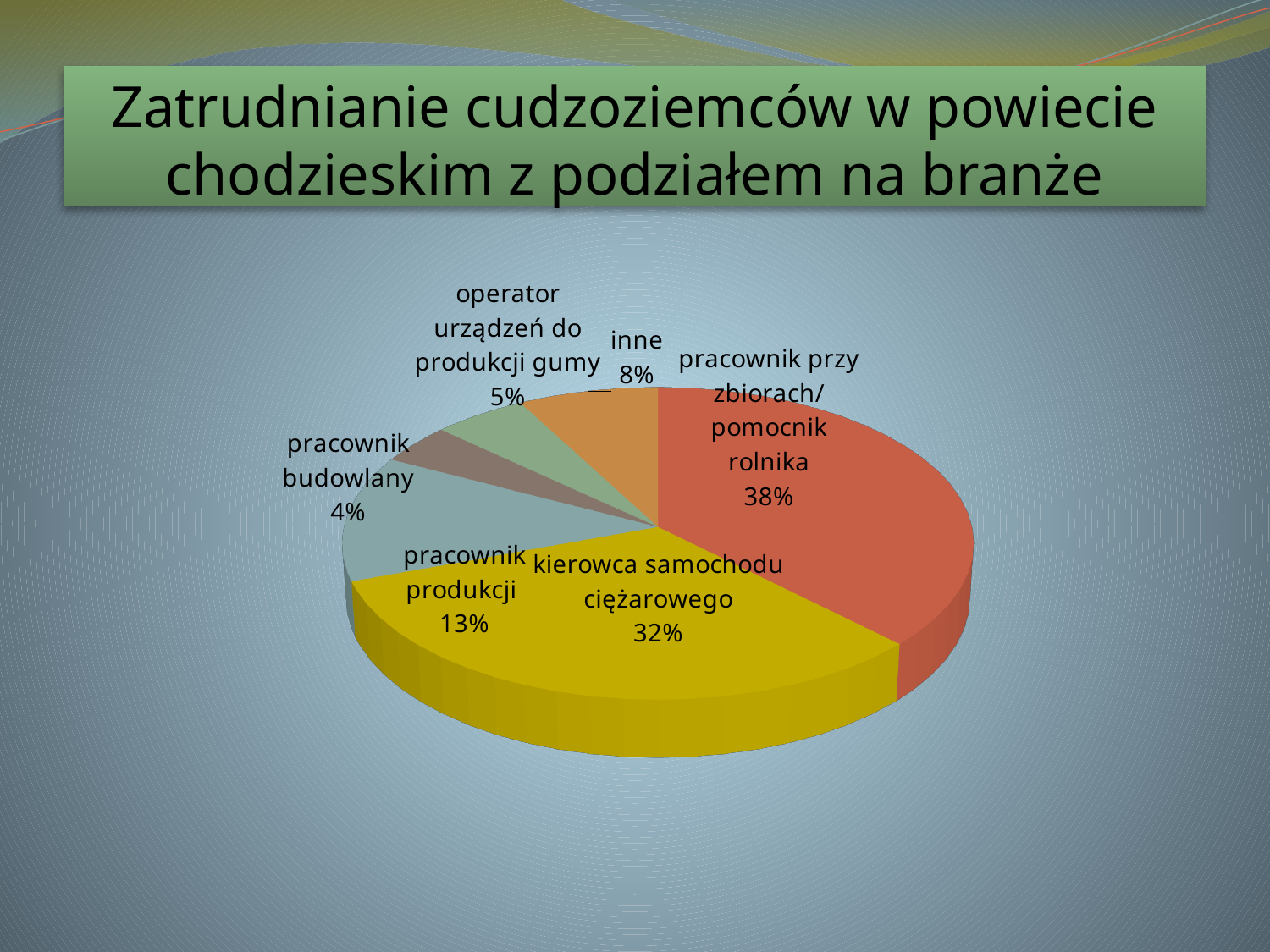
How many categories are shown in the pie chart? 6 Which category has the smallest share of the pie? pracownik budowlany What is the value shown for 'inne'? 8% What is the value shown for 'pracownik produkcji'? 13% What is the value shown for 'kierowca samochodu ciężarowego'? 32% What is the difference between the shares of 'pracownik przy zbiorach/pomocnik rolnika' and 'kierowca samochodu ciężarowego'? 6% Which category has the largest share of the pie? pracownik przy zbiorach/pomocnik rolnika What is the value shown for 'pracownik budowlany'? 4% What is the value shown for 'operator urządzeń do produkcji gumy'? 5% Which is larger, the share for 'inne' or the share for 'operator urządzeń do produkcji gumy'? inne What kind of chart is shown on the slide? pie chart What share of the pie does 'pracownik przy zbiorach/pomocnik rolnika' have? 38%